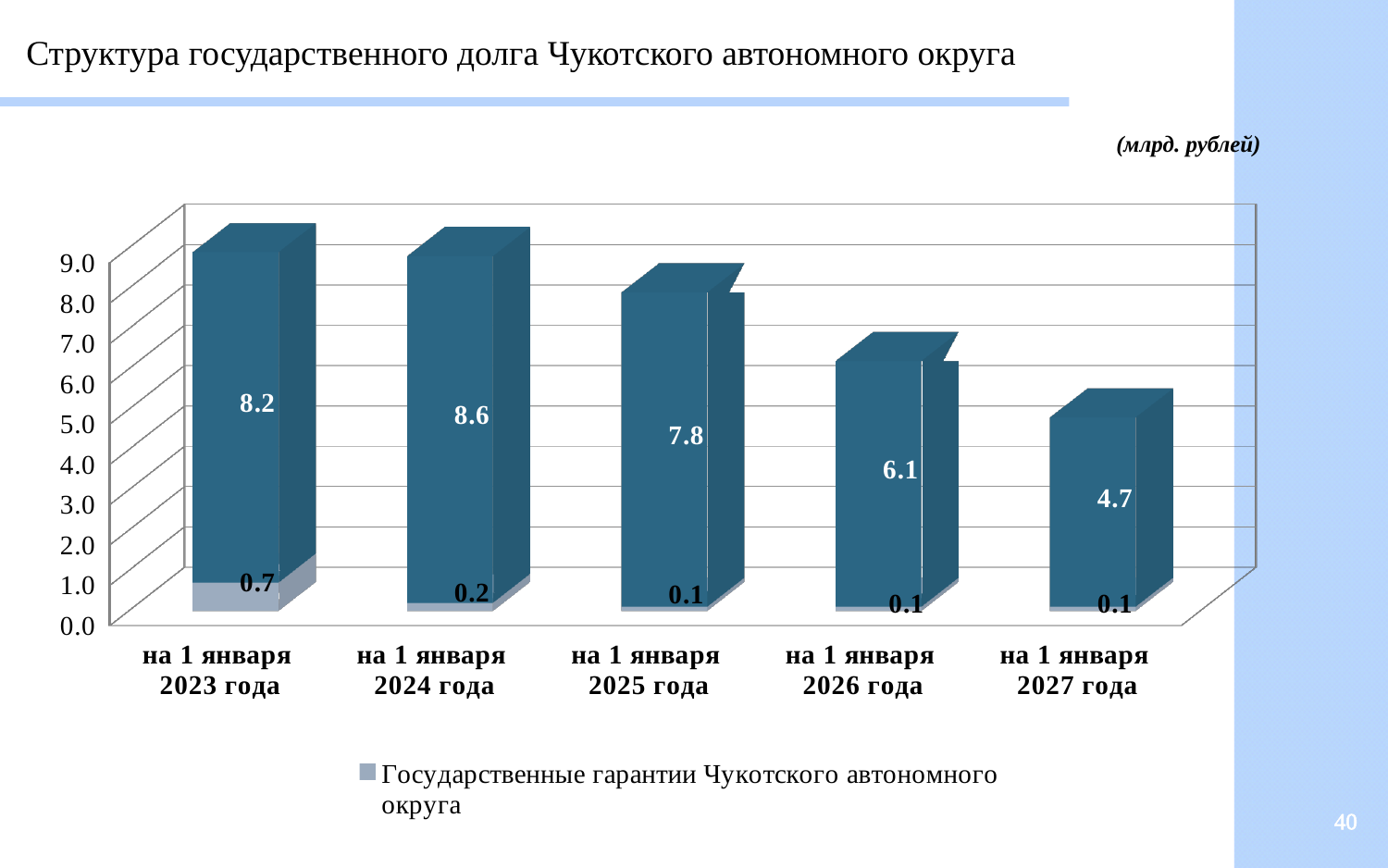
Which is larger: the Государственные гарантии value on 1 January 2023 or on 1 January 2025? на 1 января 2023 года What is the value of Государственные гарантии Чукотского автономного округа on 1 January 2023? 0.7 What kind of chart is shown on the slide? Stacked bar chart How many dates (categories) are shown on the x axis? 5 What is the value of Государственные гарантии Чукотского автономного округа on 1 January 2027? 0.1 What is the difference between the Государственные гарантии values on 1 January 2023 and 1 January 2024? 0.5 What is the total of the stacked bar for 1 January 2023? 8.9 What is the value of Государственные гарантии Чукотского автономного округа on 1 January 2024? 0.2 Do the values of Государственные гарантии Чукотского автономного округа rise or fall from 2023 to 2027? Fall In which year is the value of Государственные гарантии Чукотского автономного округа highest? на 1 января 2023 года What is the total of the stacked bar for 1 January 2027? 4.8 What is the value printed on the dark blue segment of the bar for 1 January 2025? 7.8